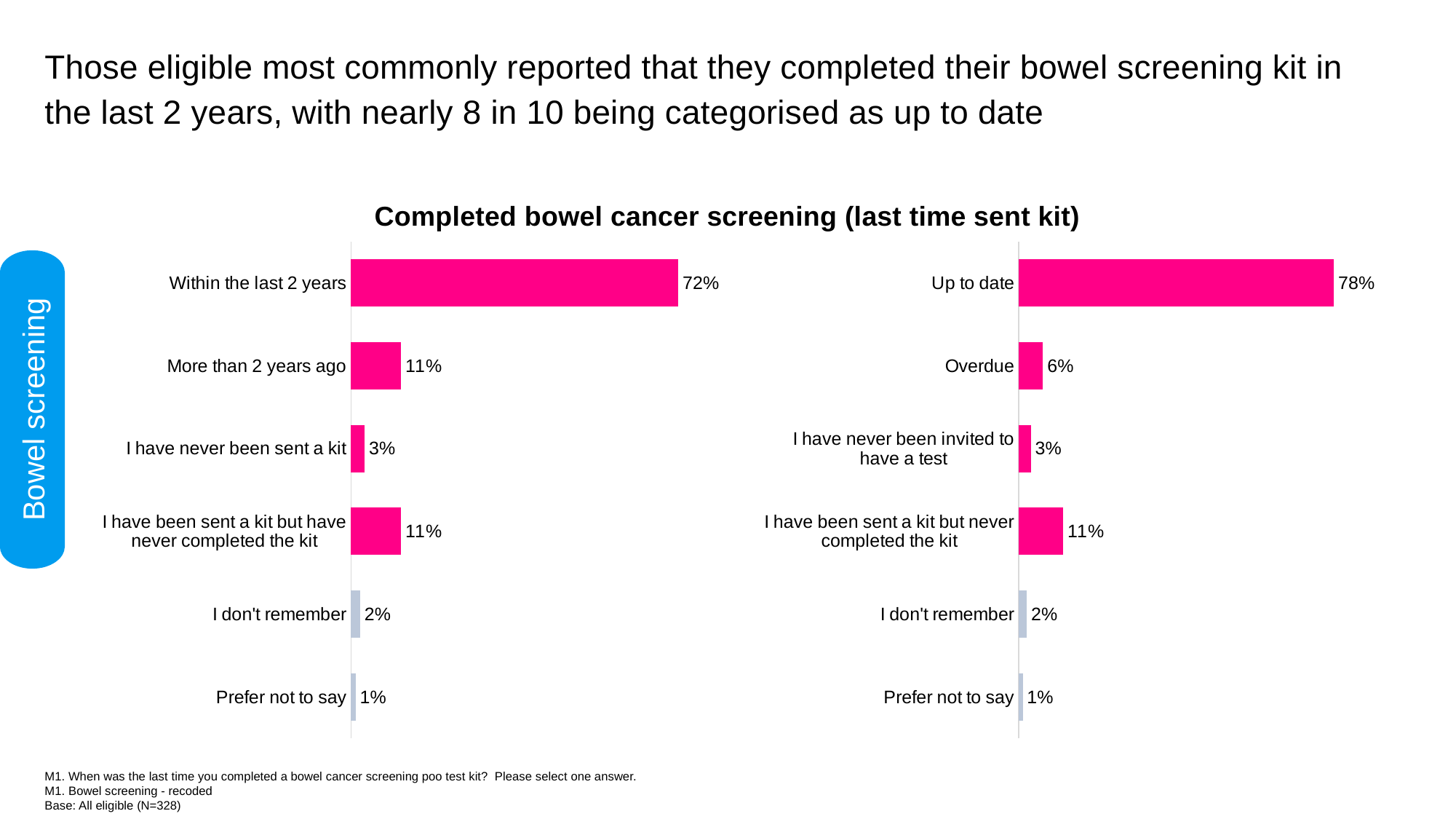
Which is larger: 'Up to date' in the right chart or 'Within the last 2 years' in the left chart? Up to date In the right chart, what is the value for Overdue? 6% In the left chart, what percentage reported completing their kit within the last 2 years? 72% In the left chart, what is the difference between 'Within the last 2 years' and 'More than 2 years ago'? 61 percentage points In the left chart, which category has the highest value? Within the last 2 years How many categories are shown in the left chart? 6 In the right chart, which category has the lowest value? Prefer not to say In the left chart, what is the value for 'I have never been sent a kit'? 3% What type of chart is used on this slide? Bar chart In the right chart, what is the difference between 'Up to date' and 'Overdue'? 72 percentage points In the right chart, what percentage are categorised as up to date? 78% What is the title shown above the charts? Completed bowel cancer screening (last time sent kit)